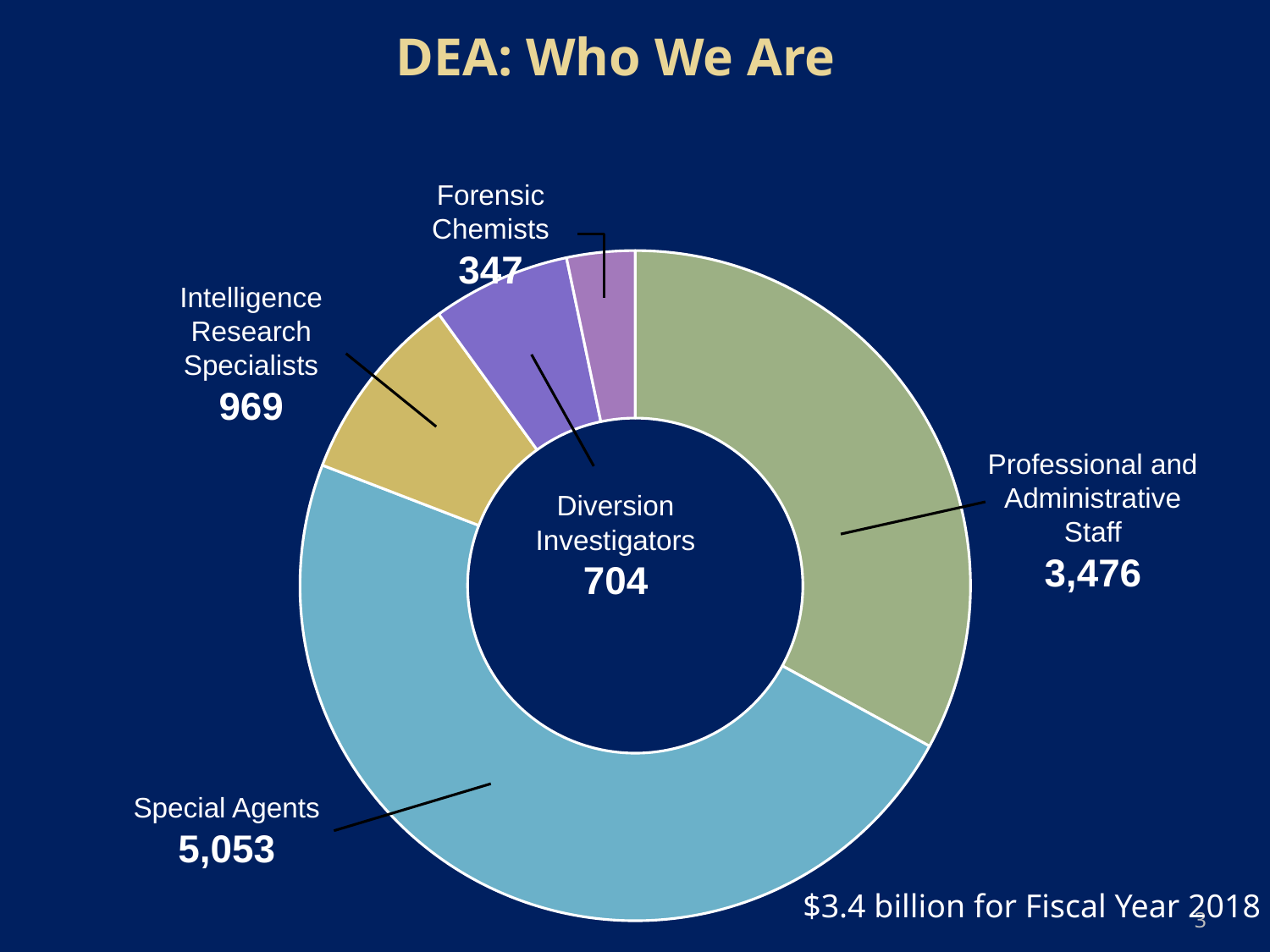
What is the value shown for Professional and Administrative Staff? 3,476 What is the value for Forensic Chemists? 347 How many categories does the chart show? 5 How many Special Agents does the chart show? 5,053 How many Diversion Investigators are shown on the chart? 704 What is the difference between the number of Special Agents and the number of Professional and Administrative Staff? 1,577 Which category has the largest value on the chart? Special Agents Which category has the smallest value on the chart? Forensic Chemists Which is larger: Intelligence Research Specialists or Diversion Investigators? Intelligence Research Specialists What kind of chart is shown on the slide? Pie chart (doughnut) How many more Intelligence Research Specialists are there than Diversion Investigators? 265 What is the title of the slide containing the chart? DEA: Who We Are